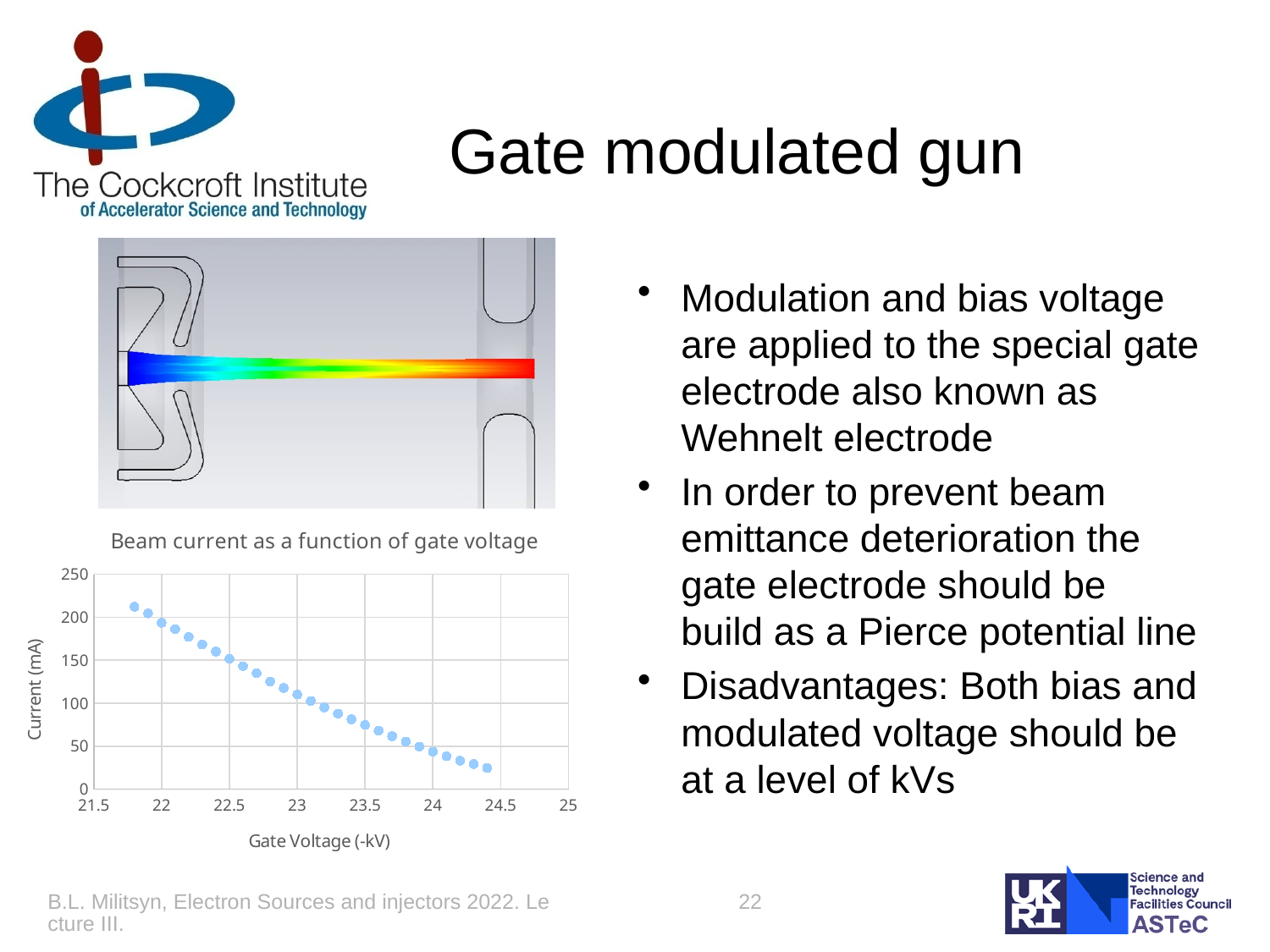
Is the current at a gate voltage of 23 (-kV) greater or less than 150 mA? less What is the title of the chart on the slide? Beam current as a function of gate voltage Which has the larger current: the point at gate voltage 22 (-kV) or the point at gate voltage 24 (-kV)? 22 (-kV) Is the current at a gate voltage of 24 (-kV) greater or less than 100 mA? less What kind of chart is shown on the slide? scatter chart What is the label of the vertical axis of the chart? Current (mA) Do the plotted current values rise or fall as gate voltage increases along the x axis? fall What is the highest tick value shown on the vertical axis of the chart? 250 Is the current at a gate voltage of 22 (-kV) greater or less than 150 mA? greater